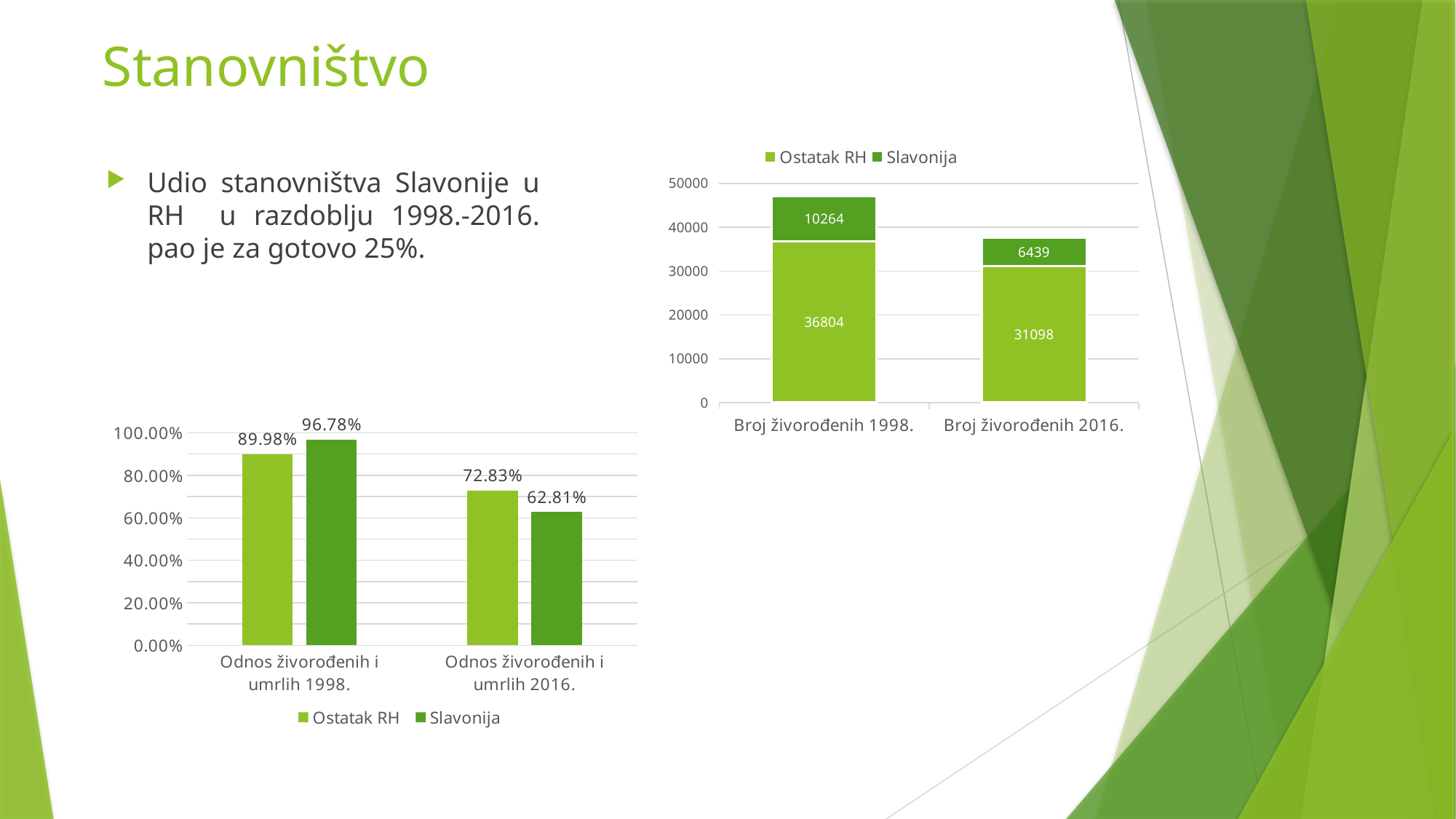
In the bar chart at the bottom left, which is larger in 1998: Ostatak RH or Slavonija? Slavonija In the bar chart at the bottom left, what is the value for Ostatak RH in Odnos živorođenih i umrlih 2016.? 72.83% In the stacked bar chart at the top right, what is the value for Ostatak RH in Broj živorođenih 2016.? 31098 In the stacked bar chart at the top right, what is the total of the Broj živorođenih 1998. bar? 47068 In the bar chart at the bottom left, what is the value for Slavonija in Odnos živorođenih i umrlih 1998.? 96.78% In the bar chart at the bottom left, what is the difference between Ostatak RH and Slavonija in Odnos živorođenih i umrlih 2016.? 10.02% In the bar chart at the bottom left, which bar has the lowest value? Slavonija, Odnos živorođenih i umrlih 2016. In the stacked bar chart at the top right, is the total for Broj živorođenih 2016. greater or less than 40000? less In the stacked bar chart at the top right, what is the total of the Broj živorođenih 2016. bar? 37537 In the stacked bar chart at the top right, what is the value for Slavonija in Broj živorođenih 1998.? 10264 How many series does the legend of the bar chart at the bottom left list? 2 In the stacked bar chart at the top right, what is the difference between the Slavonija values for 1998 and 2016? 3825